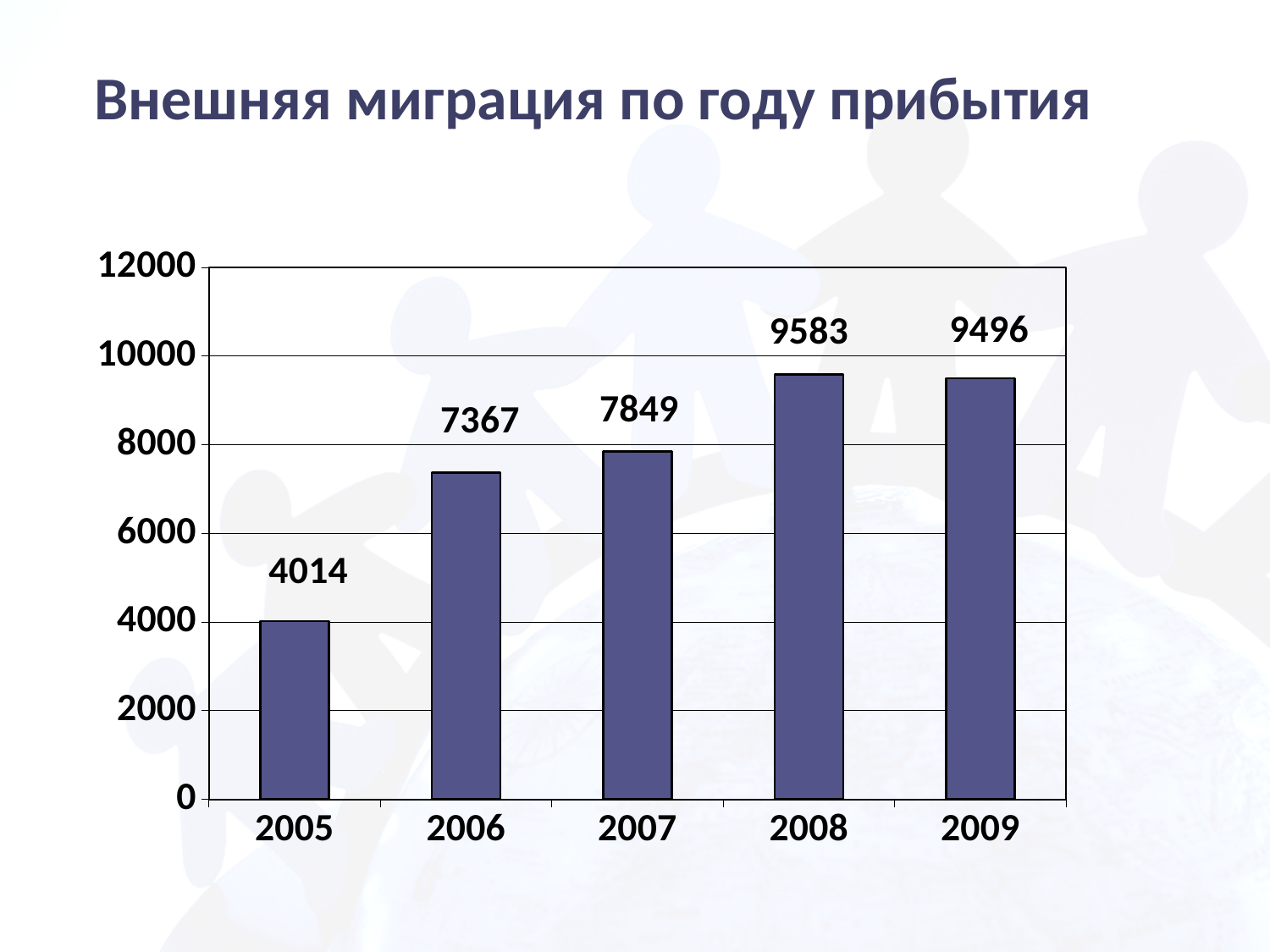
How many years are shown on the x axis? 5 Is the value for 2008 greater or less than 8000? greater Which is larger, the value for 2006 or the value for 2007? 2007 What is the difference between the values for 2008 and 2009? 87 Which year has the lowest value? 2005 What is the value for 2009? 9496 What is the value for 2007? 7849 What is the difference between the values for 2006 and 2005? 3353 What kind of chart is this? bar chart What is the title of the chart? Внешняя миграция по году прибытия What is the value for 2005? 4014 Which year has the highest value? 2008